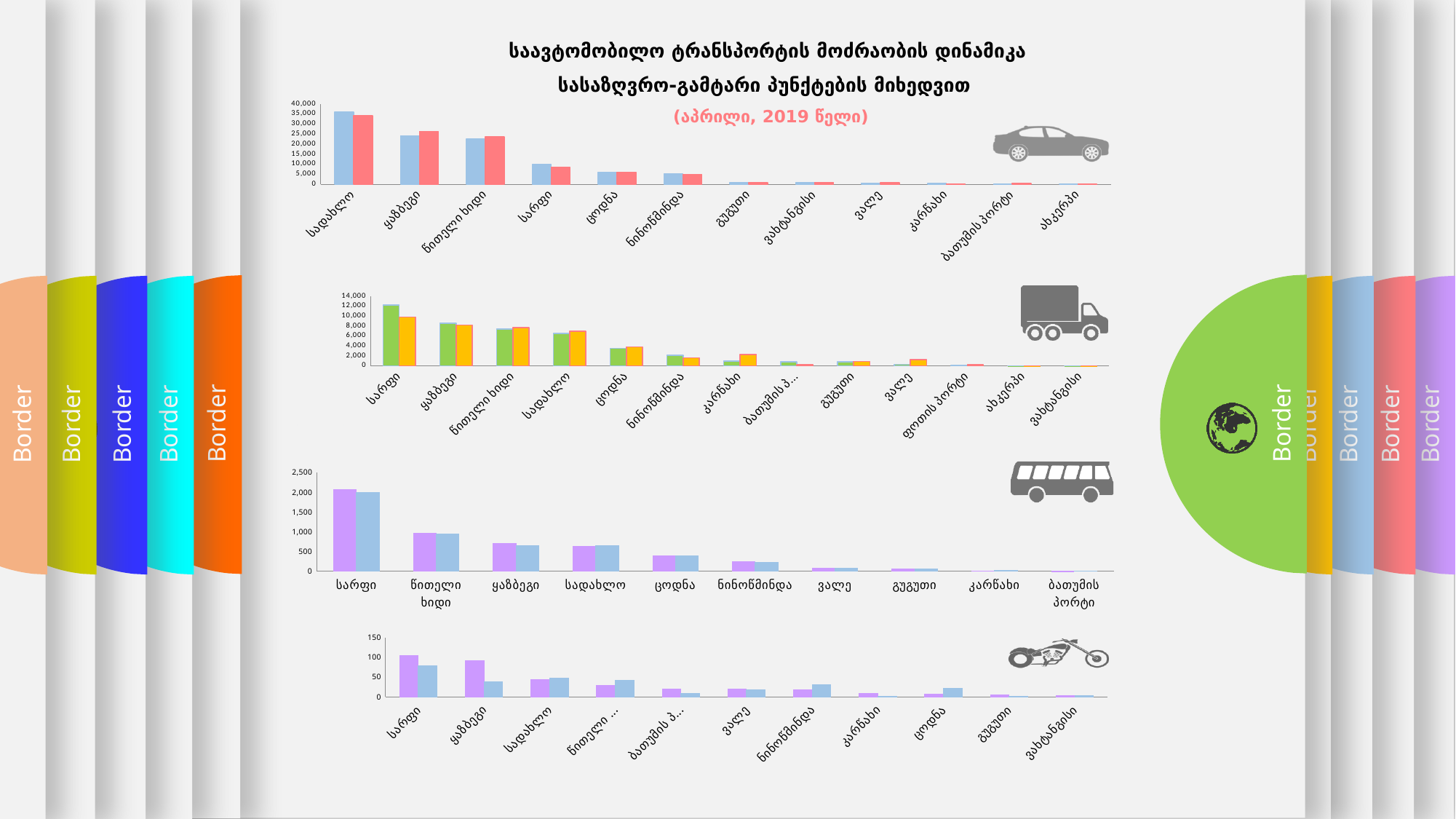
In the second chart from the top (truck icon), how many categories are shown on the x axis? 13 In the top chart (car icon), is the value of the first (blue) bar for სადახლო greater or less than 30,000? greater What kind of chart is the top chart on the slide (with the car icon)? bar chart In the top chart (car icon), which category has the highest values? სადახლო In the top chart (car icon), how many categories are shown on the x axis? 12 In the second chart from the top (truck icon), which category has the highest values? სარფი Which year is given in the subtitle of the slide's chart title? 2019 In the third chart from the top (bus icon), do the values generally rise or fall from left to right along the x axis? fall In the second chart from the top (truck icon), is the value of the first (green) bar for სარფი greater or less than 10,000? greater In the bottom chart (motorcycle icon), which is larger, the first (purple) bar for სარფი or the first (purple) bar for ყაზბეგი? სარფი